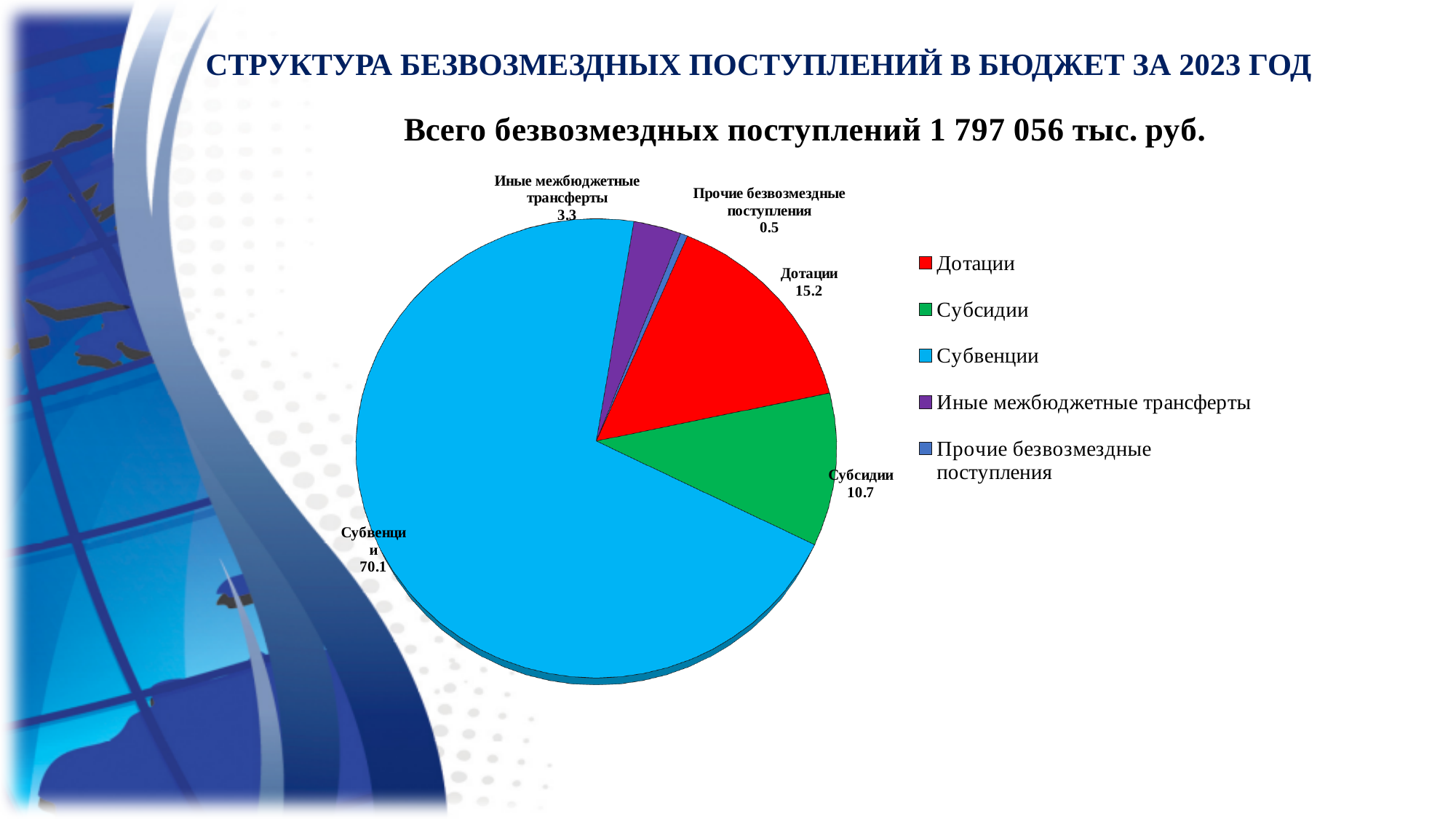
What is the value shown for Дотации? 15.2 What is the value shown for Субвенции? 70.1 How many categories does the legend list? 5 Which category has the smallest slice of the pie? Прочие безвозмездные поступления What is the value shown for Прочие безвозмездные поступления? 0.5 Which is larger, the value for Субсидии or the value for Иные межбюджетные трансферты? Субсидии What total amount of gratuitous receipts is stated in the chart title? 1 797 056 тыс. руб. What type of chart is shown on the slide? Pie chart What is the difference between the values for Дотации and Субсидии? 4.5 What is the value shown for Субсидии? 10.7 Which category has the largest slice of the pie? Субвенции What is the value shown for Иные межбюджетные трансферты? 3.3